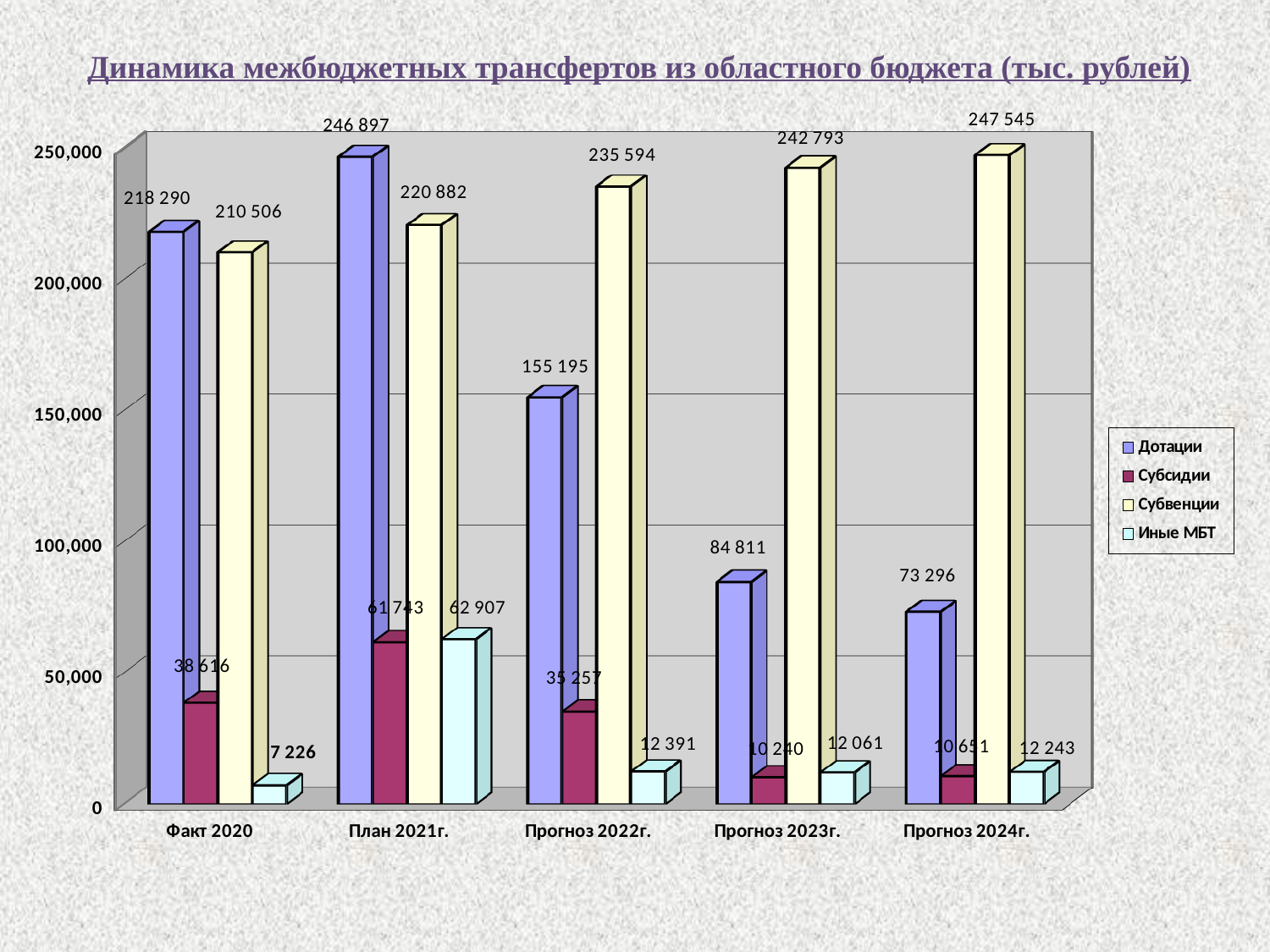
What kind of chart is shown on the slide? bar chart What is the value of Иные МБТ for План 2021г.? 62 907 What is the difference between the Дотации values for План 2021г. and Факт 2020? 28 607 Do the Субвенции values rise or fall from Факт 2020 to Прогноз 2024г.? rise In which category is the Иные МБТ value lowest? Факт 2020 How many series does the legend list? 4 How many categories are shown on the x axis? 5 Is the Дотации value for Прогноз 2023г. greater or less than 100,000? less What is the value of Субвенции for Прогноз 2024г.? 247 545 In which category is the Дотации value highest? План 2021г. What is the value of Дотации for Факт 2020? 218 290 For Факт 2020, which is larger: Дотации or Субвенции? Дотации